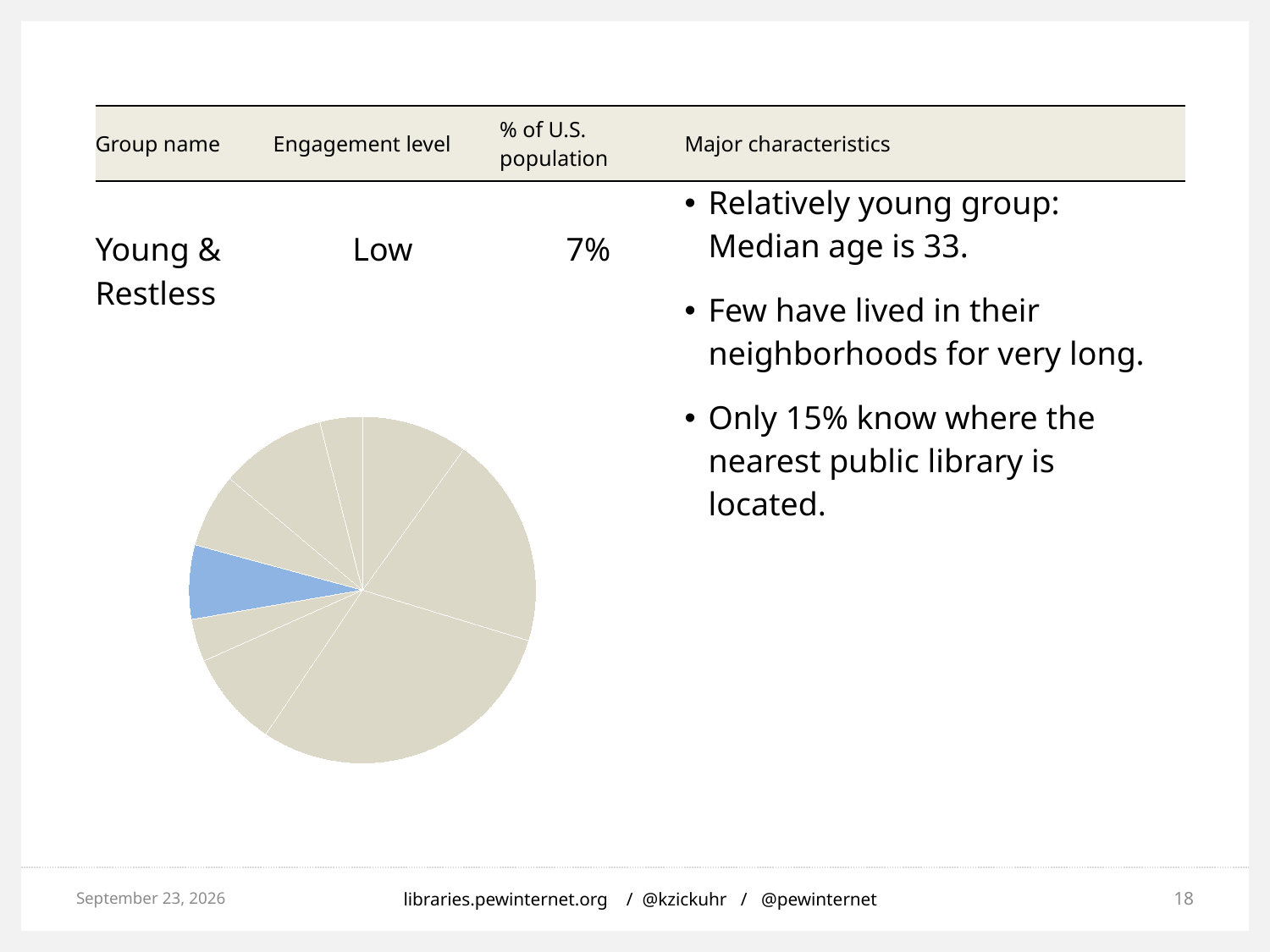
Is the highlighted blue slice the largest slice of the pie chart? No Which group does the highlighted slice of the pie chart correspond to? Young & Restless What colour is the highlighted slice of the pie chart? blue What share of the U.S. population does the highlighted blue slice of the pie chart represent, according to the table? 7% What kind of chart is shown on the slide? pie chart How many slices does the pie chart have? 9 Does the pie chart have a legend? No